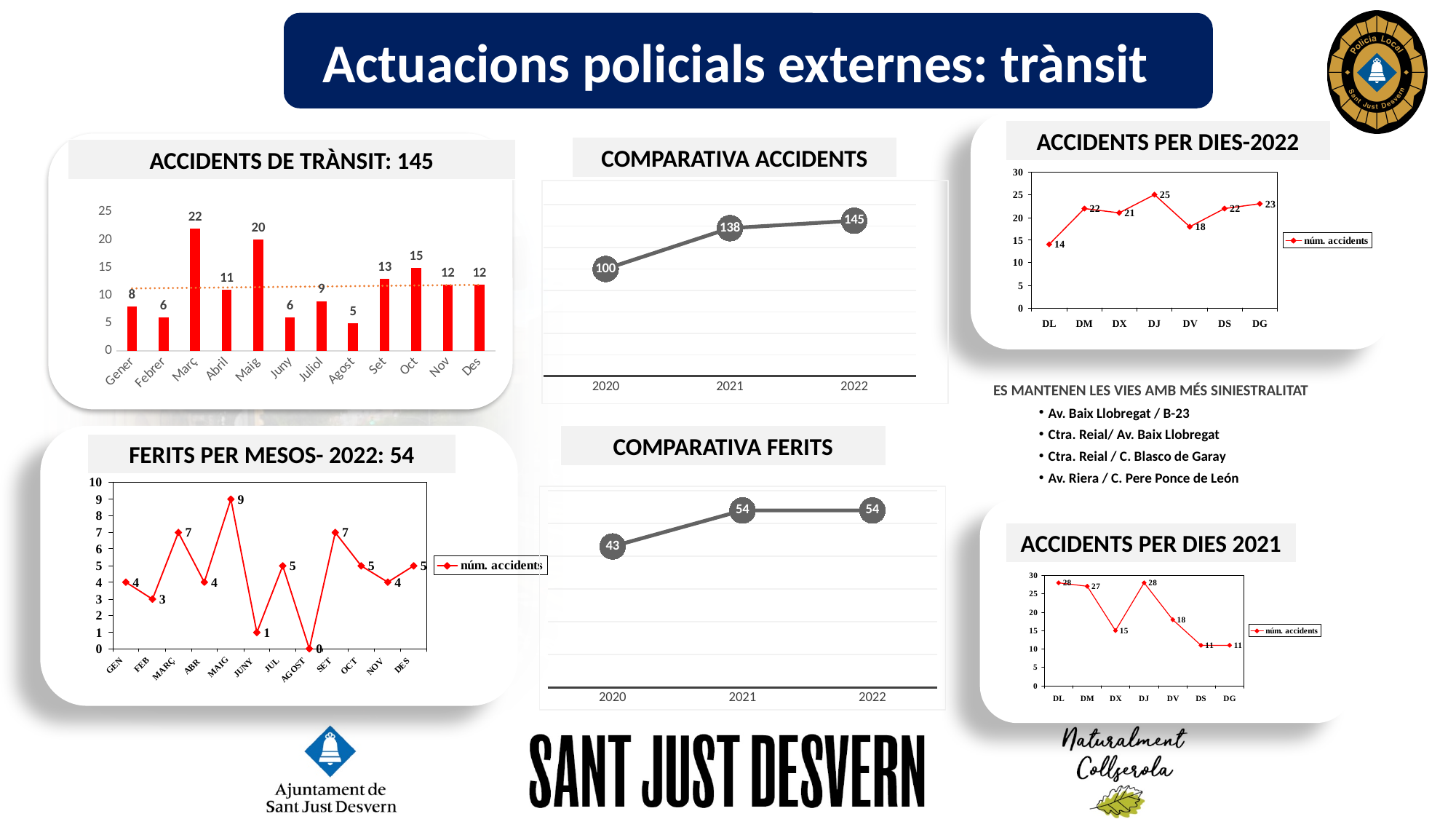
In the 'ACCIDENTS PER DIES-2022' chart, what is the value for DV? 18 In the 'ACCIDENTS DE TRÀNSIT: 145' chart, what is the value for Març? 22 In the 'ACCIDENTS DE TRÀNSIT: 145' chart, which month has the lowest value? Agost What kind of chart is 'ACCIDENTS DE TRÀNSIT: 145'? bar chart In the 'FERITS PER MESOS- 2022: 54' chart, which month has the highest value? MAIG In the 'ACCIDENTS DE TRÀNSIT: 145' chart, what is the difference between Maig and Juny? 14 In the 'COMPARATIVA FERITS' chart, what is the difference between 2021 and 2020? 11 In the 'ACCIDENTS PER DIES 2021' chart, which is larger, DX or DV? DV In the 'FERITS PER MESOS- 2022: 54' chart, how many months are plotted? 12 In the 'COMPARATIVA ACCIDENTS' chart, what is the value for 2021? 138 In the 'COMPARATIVA ACCIDENTS' chart, do the values rise or fall from 2020 to 2022? rise In the 'ACCIDENTS PER DIES-2022' chart, which day has the highest value? DJ